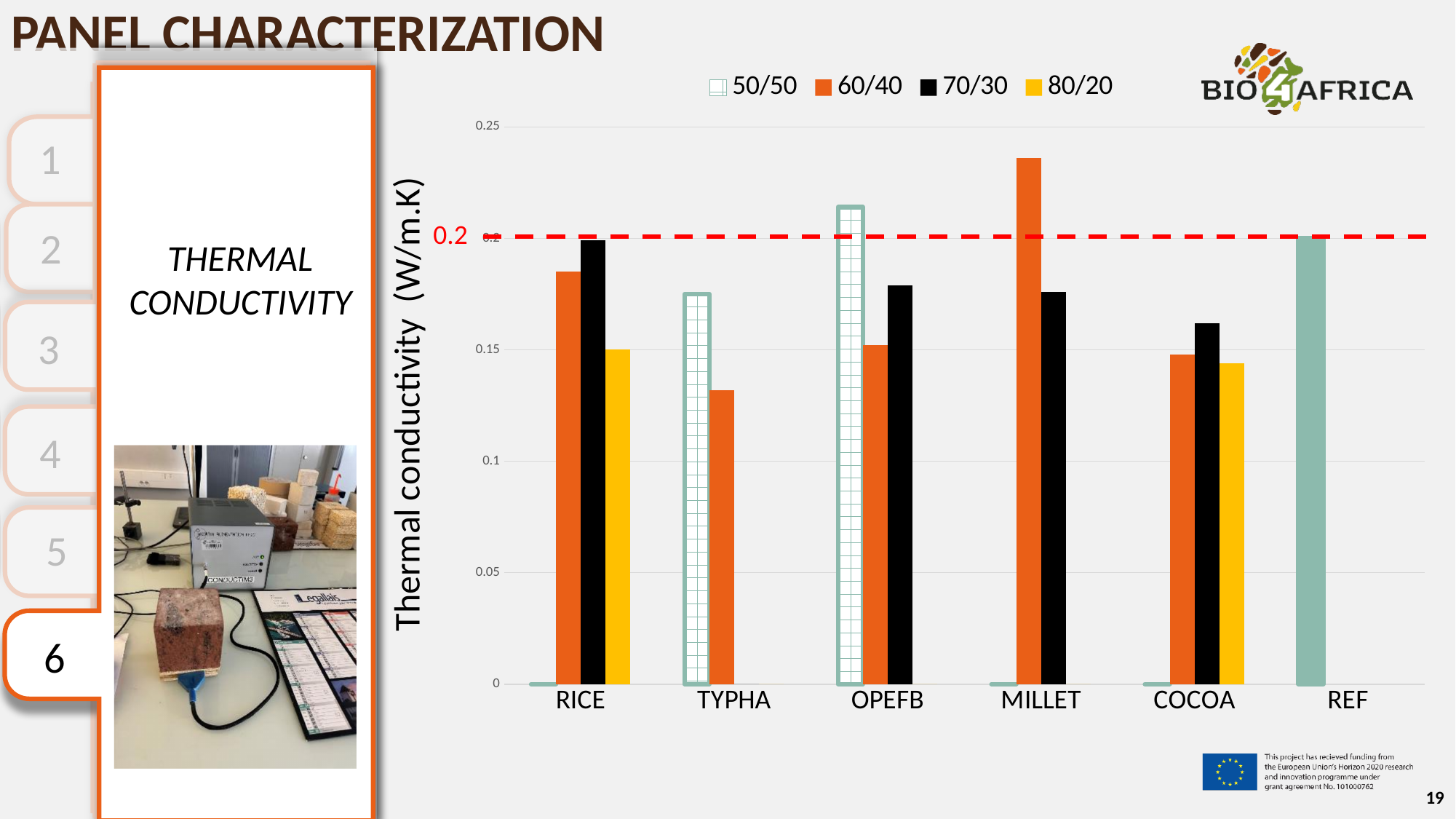
What is the label of the y axis of the chart? Thermal conductivity (W/m.K) What kind of chart is shown on the slide? bar chart Is the 60/40 value for MILLET greater or less than 0.2? greater Which is larger, the 50/50 value for OPEFB or the 50/50 value for TYPHA? OPEFB Is the 50/50 value for OPEFB greater or less than 0.2? greater How many series does the chart legend list? 4 Which category has the highest value for the 60/40 series? MILLET Is the 60/40 value for TYPHA greater or less than 0.15? less Which category has the lowest value for the 60/40 series? TYPHA How many categories are shown on the x axis of the chart? 6 Which category has the highest bar in the chart? MILLET